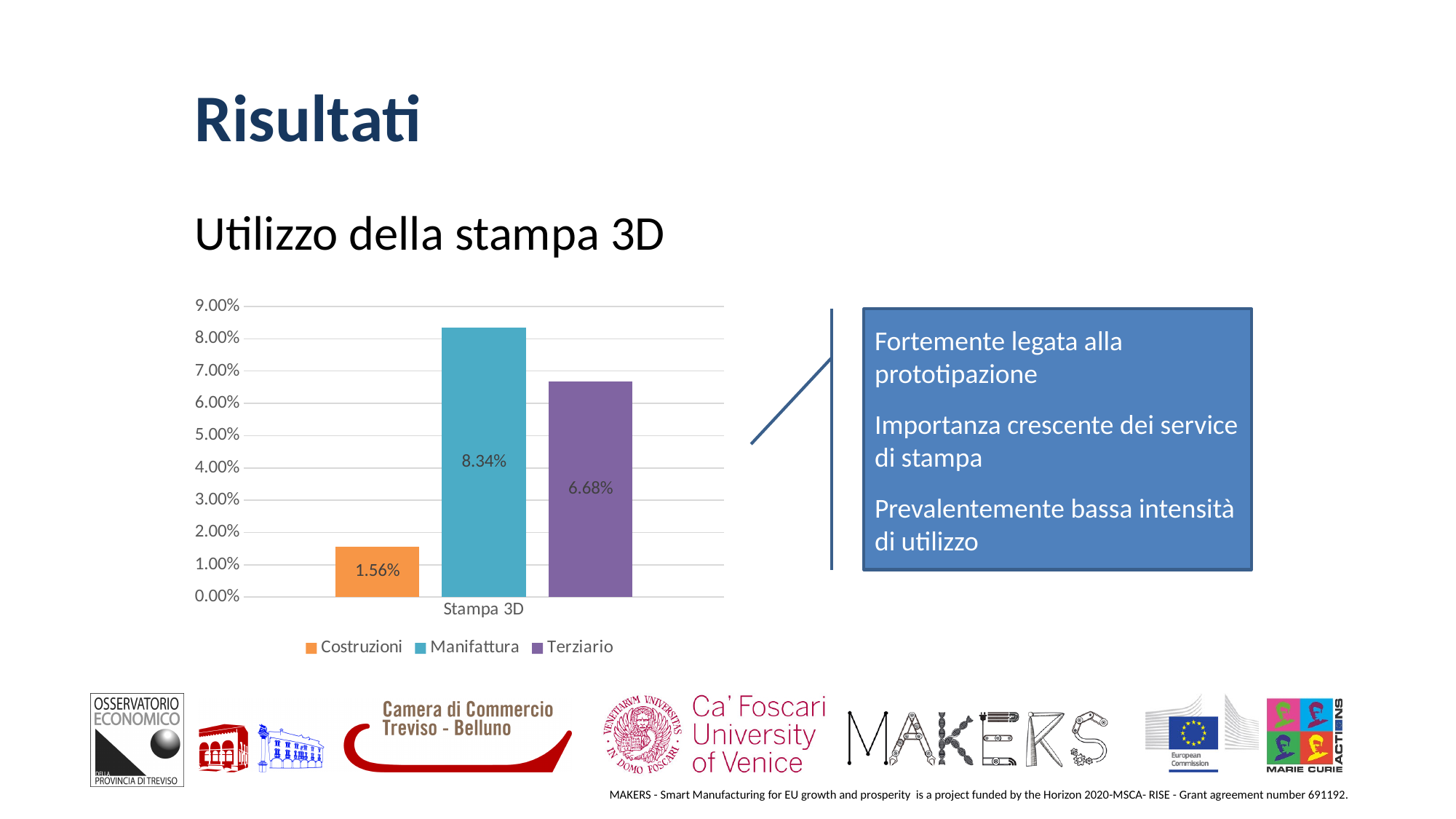
What is the value for Manifattura in the chart? 8.34% What is the value for Terziario in the chart? 6.68% What kind of chart is shown on the slide? bar chart What is the value for Costruzioni in the chart? 1.56% Which series has the highest value in the chart? Manifattura What is the difference between the values for Terziario and Costruzioni? 5.12% How many series does the legend list? 3 What is the difference between the values for Manifattura and Terziario? 1.66% Which series has the lowest value in the chart? Costruzioni Which is larger, the value for Terziario or the value for Costruzioni? Terziario Is the value for Manifattura greater or less than 8.00%? greater What is the category label shown on the x axis of the chart? Stampa 3D